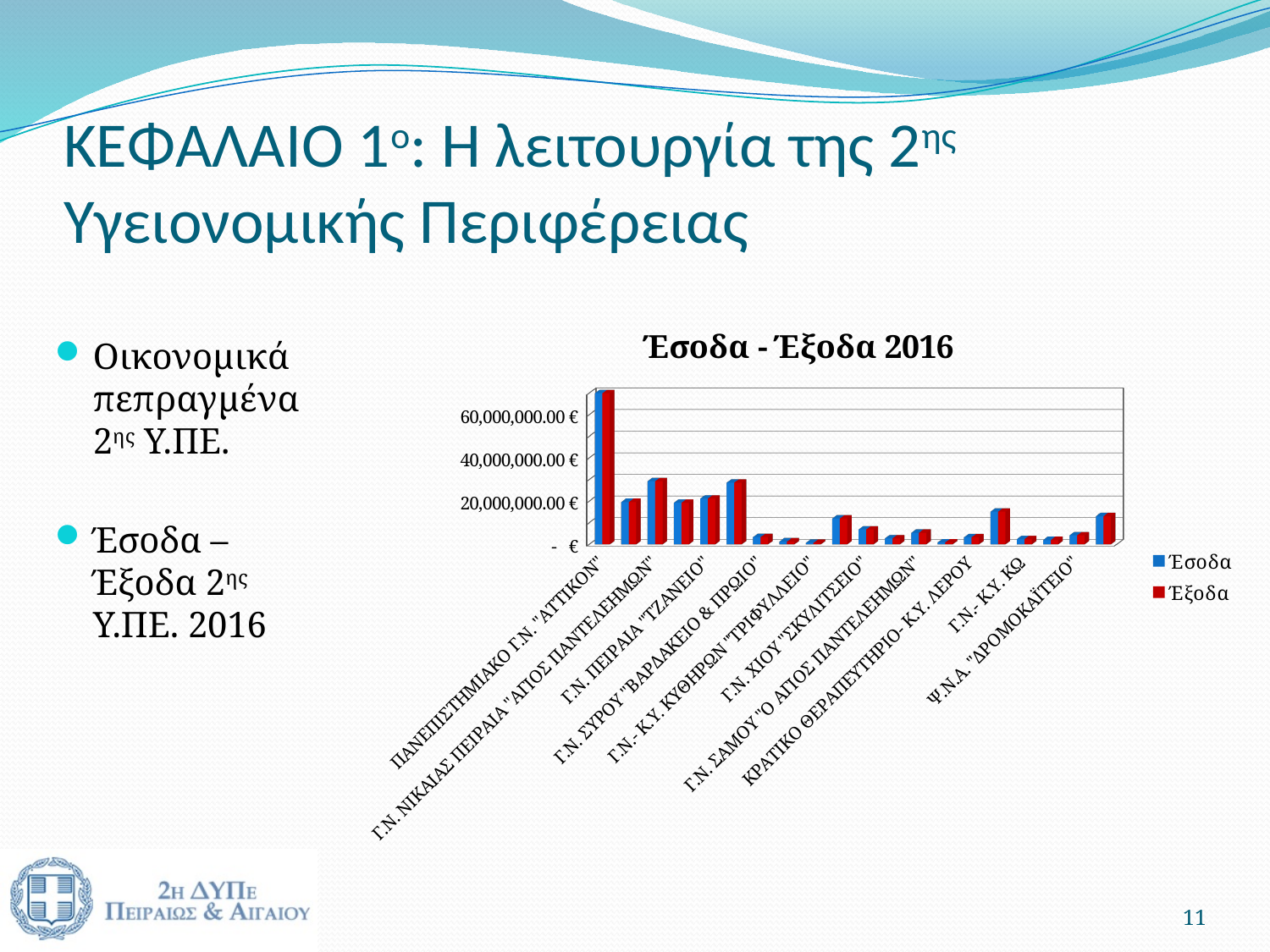
Which category has the highest Έξοδα value in the chart? ΠΑΝΕΠΙΣΤΗΜΙΑΚΟ Γ.Ν. "ΑΤΤΙΚΟΝ" What is the title of the chart on the slide? Έσοδα - Έξοδα 2016 What are the two series listed in the chart's legend? Έσοδα and Έξοδα What kind of chart is shown on the slide? bar chart Which category has the highest Έσοδα value in the chart? ΠΑΝΕΠΙΣΤΗΜΙΑΚΟ Γ.Ν. "ΑΤΤΙΚΟΝ" Is the Έξοδα value for ΠΑΝΕΠΙΣΤΗΜΙΑΚΟ Γ.Ν. "ΑΤΤΙΚΟΝ" greater or less than 40,000,000.00 €? greater Is the Έσοδα value for ΠΑΝΕΠΙΣΤΗΜΙΑΚΟ Γ.Ν. "ΑΤΤΙΚΟΝ" greater or less than 60,000,000.00 €? greater What is the highest value labelled on the chart's vertical axis? 60,000,000.00 € Is the Έσοδα value for Ψ.Ν.Α. "ΔΡΟΜΟΚΑΪΤΕΙΟ" greater or less than 20,000,000.00 €? less Which is larger: the Έσοδα value for ΠΑΝΕΠΙΣΤΗΜΙΑΚΟ Γ.Ν. "ΑΤΤΙΚΟΝ" or the Έσοδα value for Ψ.Ν.Α. "ΔΡΟΜΟΚΑΪΤΕΙΟ"? ΠΑΝΕΠΙΣΤΗΜΙΑΚΟ Γ.Ν. "ΑΤΤΙΚΟΝ" How many series does the chart's legend list? 2